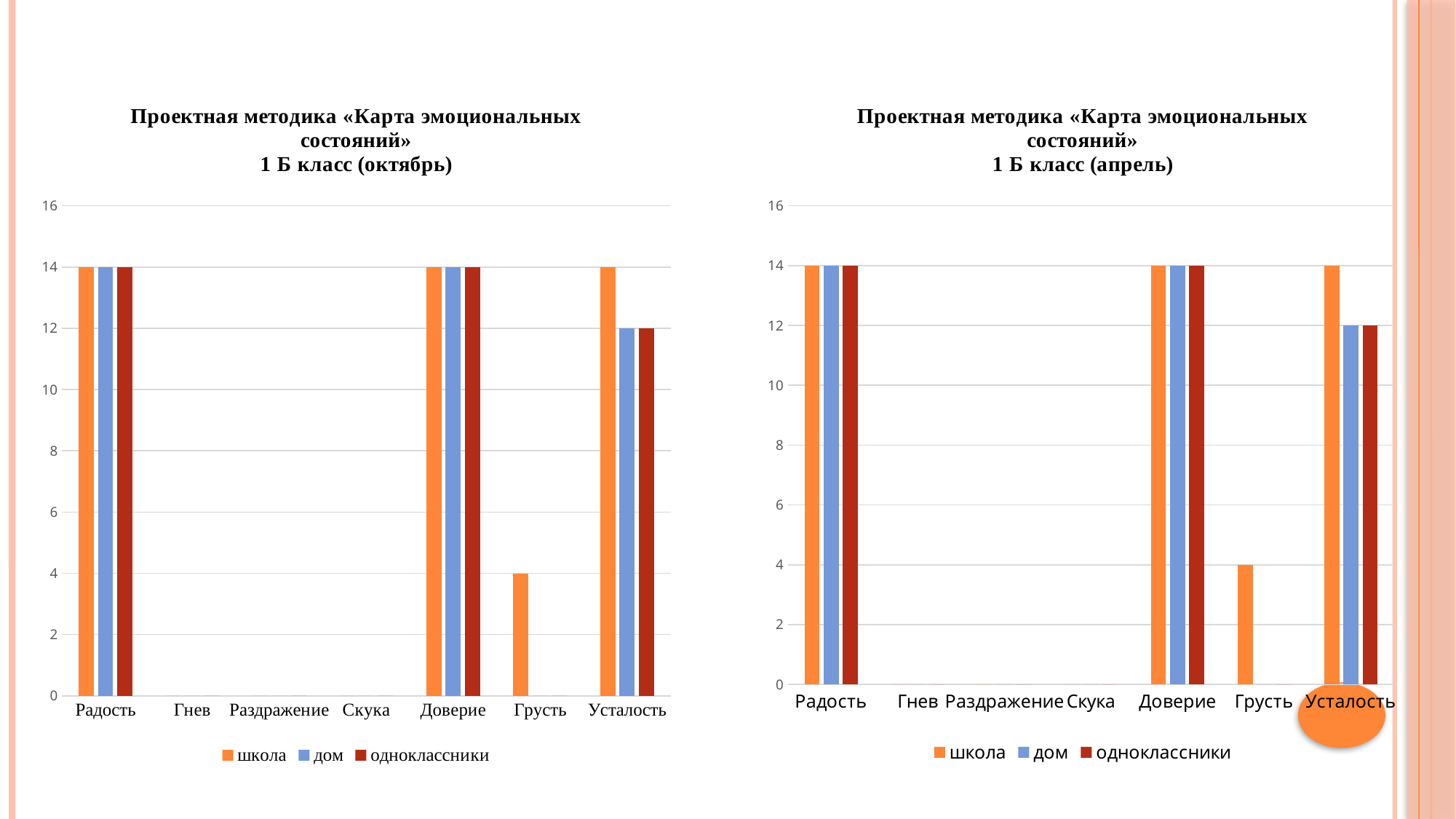
In the left chart (октябрь), what is the value for дом in the Усталость category? 12 In the left chart (октябрь), what is the value for школа in the Грусть category? 4 How many series does the legend of the left chart (октябрь) list? 3 In the right chart (апрель), what is the value for школа in the Усталость category? 14 In the right chart (апрель), which is larger for Грусть: the школа value or the дом value? школа What colour represents the series одноклассники in the legend of the right chart (апрель)? dark red In the left chart (октябрь), is the школа value for Грусть greater or less than 8? less What kind of chart is the left chart (1 Б класс, октябрь)? bar chart In the left chart (октябрь), what is the difference between the школа value and the дом value for Усталость? 2 In the right chart (апрель), which category has the lowest школа value among those with a visible bar? Грусть In the right chart (апрель), what is the value for одноклассники in the Радость category? 14 How many categories are shown on the x axis of the right chart (апрель)? 7